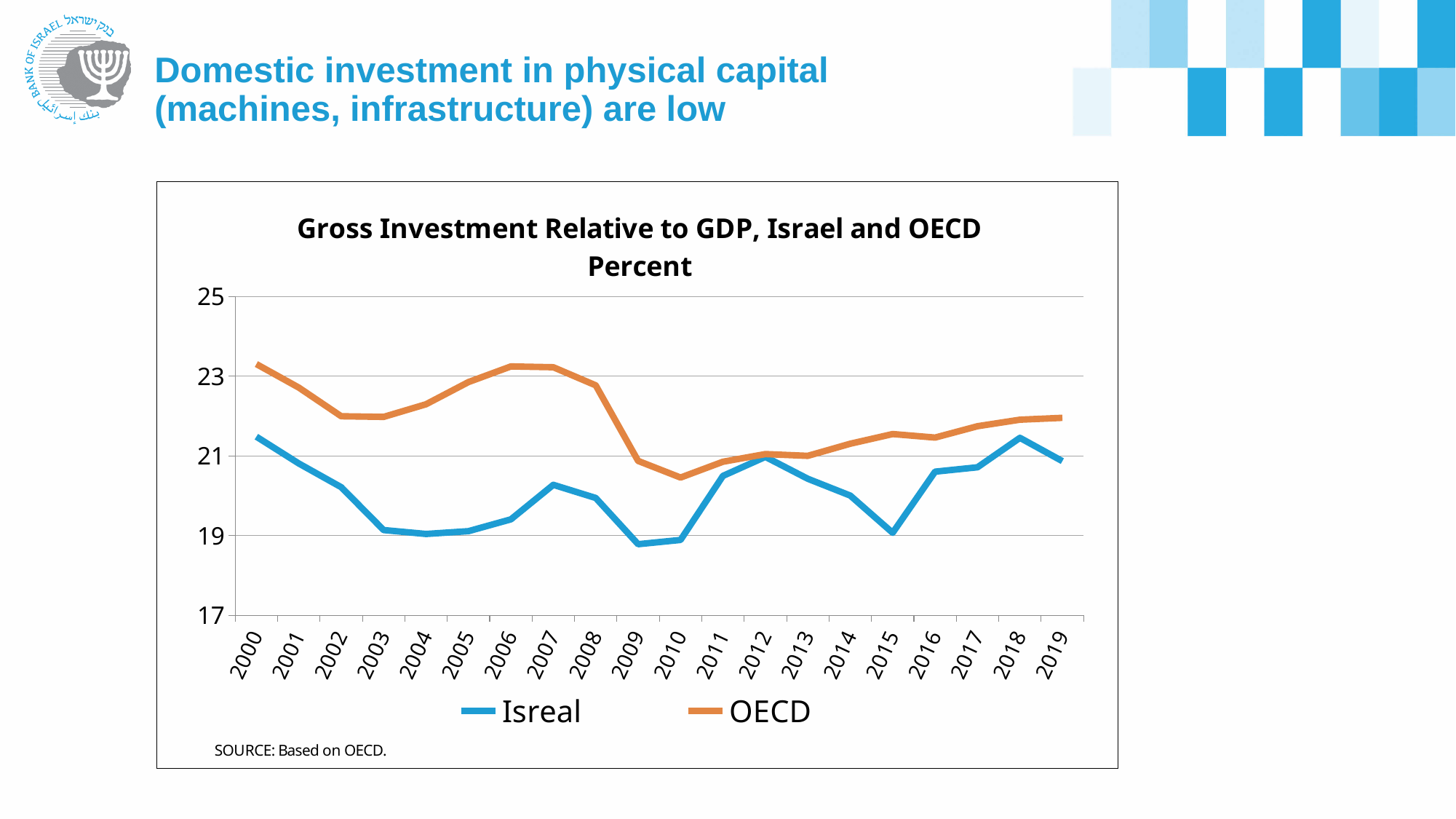
Does the Isreal series rise or fall from 2000 to 2003? Fall How many years are plotted along the x axis? 20 Is the OECD value for 2010 greater or less than 21? less Is the OECD value for 2000 greater or less than 23? greater Is the OECD value for 2019 greater or less than 21? greater How many series does the legend list? 2 In 2009, which series has the higher value, Isreal or OECD? OECD What kind of chart is shown on the slide? Line chart What colour is the line for the OECD series? Orange Does the OECD series rise or fall from 2010 to 2019? Rise In which year does the OECD series reach its lowest value? 2010